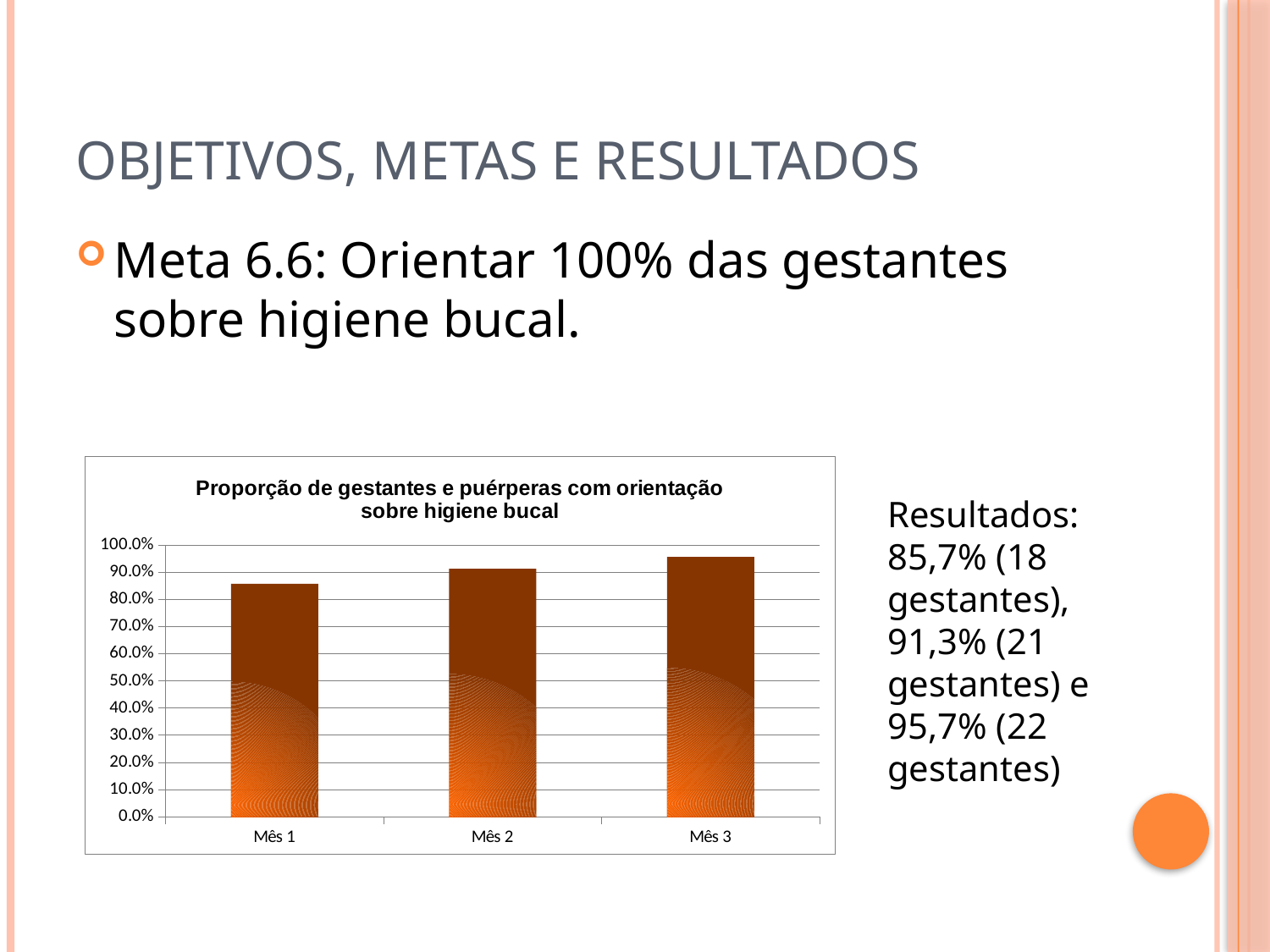
What kind of chart is shown on the slide? bar chart What is the title of the chart? Proporção de gestantes e puérperas com orientação sobre higiene bucal Which month has the lowest bar in the chart? Mês 1 Do the values rise or fall from Mês 1 to Mês 3? rise How many categories are shown on the x axis of the chart? 3 Which month has the highest bar in the chart? Mês 3 Is the value for Mês 1 greater or less than 90.0%? less Which is larger, the value for Mês 2 or the value for Mês 3? Mês 3 Is the value for Mês 1 greater or less than 80.0%? greater What is the maximum value shown on the y axis of the chart? 100.0% Is the value for Mês 3 greater or less than 100.0%? less